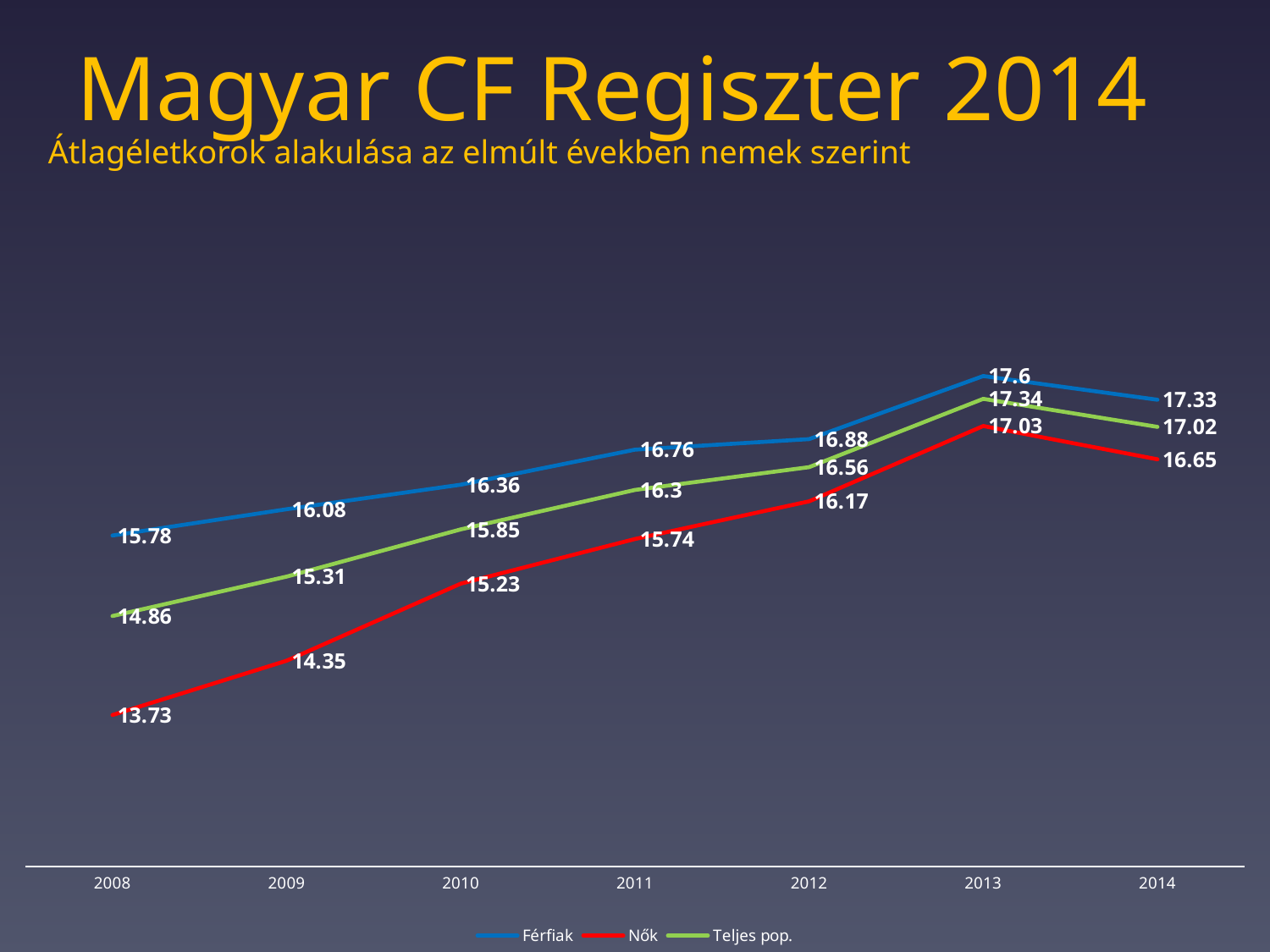
In which year is the Nők series lowest? 2008 How many series does the legend list? 3 What is the value for Teljes pop. in 2014? 17.02 In which year is the Férfiak series highest? 2013 Does the Nők series rise or fall from 2008 to 2013? rise What is the value for Nők in 2010? 15.23 Which series is drawn in red? Nők What kind of chart is shown on the slide? line chart What is the value for Férfiak in 2008? 15.78 What is the difference between the Férfiak and Nők values in 2008? 2.05 Which is larger in 2012, the Férfiak value or the Teljes pop. value? Férfiak How many years are shown on the x axis? 7